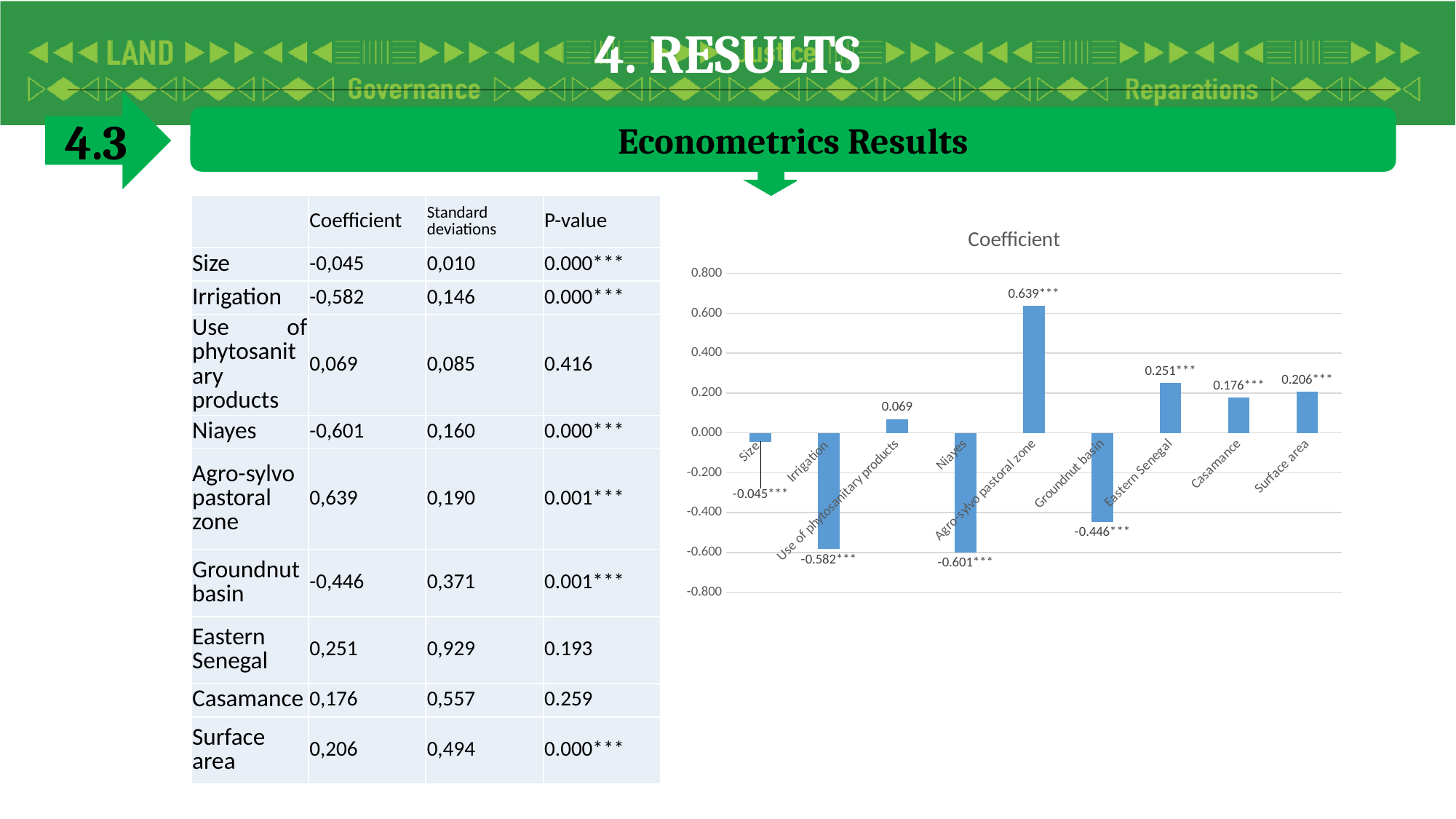
What kind of chart is shown on the slide? bar chart How many categories are plotted in the chart? 9 What is the data label shown for Casamance in the chart? 0.176*** Which category has the highest coefficient in the chart? Agro-sylvo pastoral zone How many categories in the chart have a negative coefficient? 4 What is the data label shown for Use of phytosanitary products in the chart? 0.069 What is the title of the chart? Coefficient Which category has the lowest coefficient in the chart? Niayes Which has the larger coefficient in the chart, Eastern Senegal or Surface area? Eastern Senegal What is the data label shown for Groundnut basin in the chart? -0.446*** What is the difference between the coefficients for Agro-sylvo pastoral zone and Eastern Senegal in the chart? 0.388 Is the value for Irrigation in the chart greater or less than -0.400? less